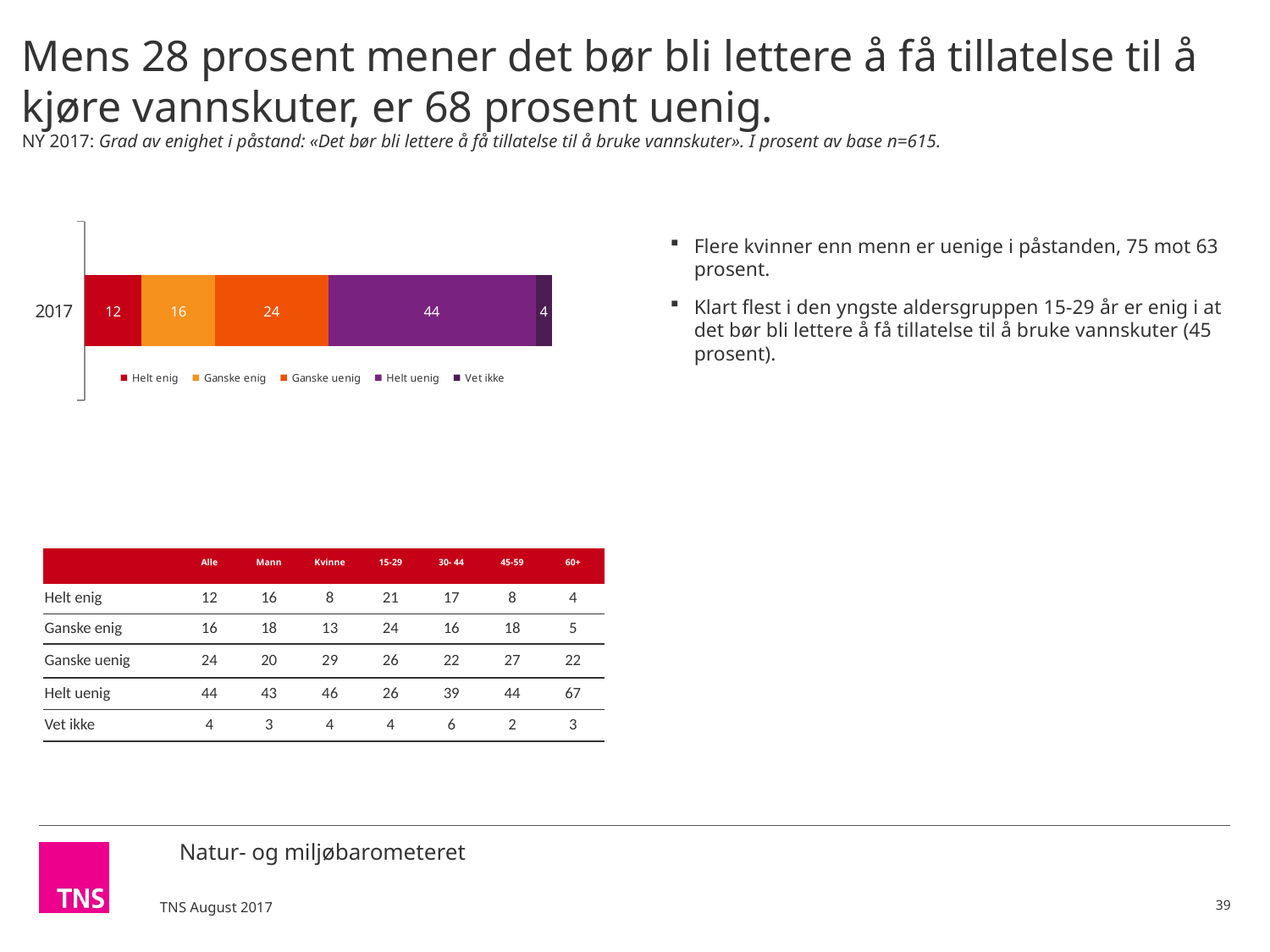
What is the value of the Vet ikke segment in the 2017 bar? 4 Which segment of the 2017 bar has the smallest value? Vet ikke How many series does the chart legend list? 5 What is the value of the Helt enig segment in the 2017 bar? 12 What type of chart is shown on the slide? stacked bar chart What is the total of all segments in the 2017 bar? 100 What is the value of the Ganske uenig segment in the 2017 bar? 24 What is the category label shown on the bar's axis? 2017 Which segment of the 2017 bar has the largest value? Helt uenig Which is larger in the 2017 bar, Ganske enig or Ganske uenig? Ganske uenig What is the value of the Helt uenig segment in the 2017 bar? 44 What is the difference between the Helt uenig and Ganske uenig values in the 2017 bar? 20